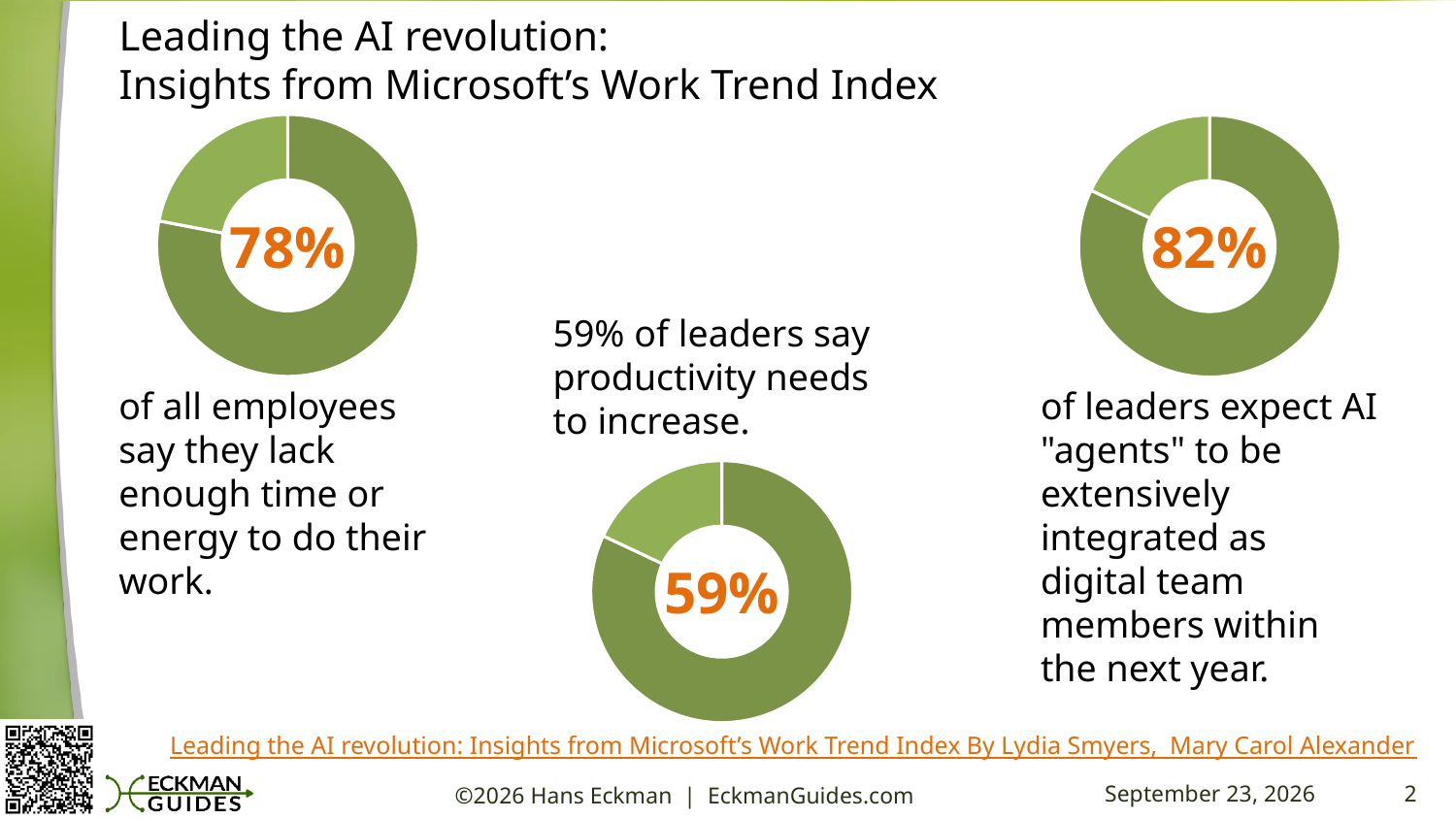
What is the difference between the percentage in the left donut chart and the percentage in the middle donut chart? 19 percentage points What percentage is shown in the centre of the right donut chart (leaders who expect AI agents to be integrated as digital team members)? 82% What colour is the larger segment in each of the donut charts? Dark olive green Which of the three donut charts shows the highest percentage? The right chart (82%) Which of the three donut charts shows the lowest percentage? The middle chart (59%) What kind of chart is used to display the three statistics on the slide? Donut chart Which is larger: the percentage in the left donut chart or the percentage in the middle donut chart? The left chart (78%) What percentage is shown in the centre of the middle donut chart (leaders who say productivity needs to increase)? 59% How many donut charts are on the slide? 3 In the left donut chart, what share of the ring is taken up by the smaller, lighter green segment? 22% What percentage is shown in the centre of the left donut chart (employees who lack enough time or energy)? 78% What is the difference between the percentage in the right donut chart and the percentage in the left donut chart? 4 percentage points